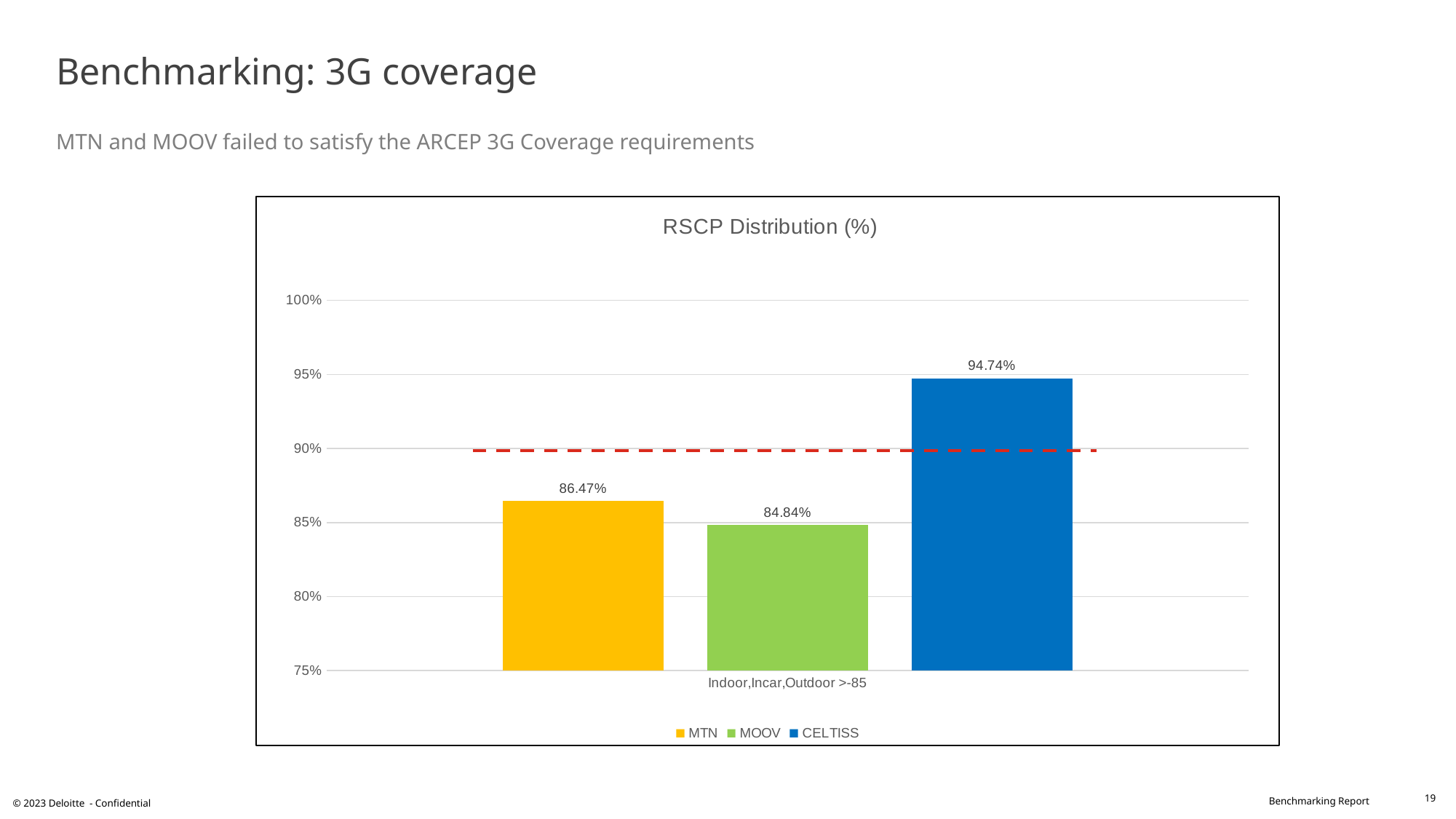
Which operator has the highest RSCP Distribution value? CELTISS What kind of chart is shown on the slide? Bar chart What is the difference between the MTN and MOOV values? 1.63% What is the difference between the CELTISS and MTN values? 8.27% Which is larger, the value for MTN or the value for MOOV? MTN What is the title of the chart? RSCP Distribution (%) What is the RSCP Distribution value for CELTISS? 94.74% What is the RSCP Distribution value for MOOV? 84.84% Is the value for CELTISS greater or less than 90%? greater Which operator has the lowest RSCP Distribution value? MOOV What is the RSCP Distribution value for MTN? 86.47% How many series does the legend list? 3